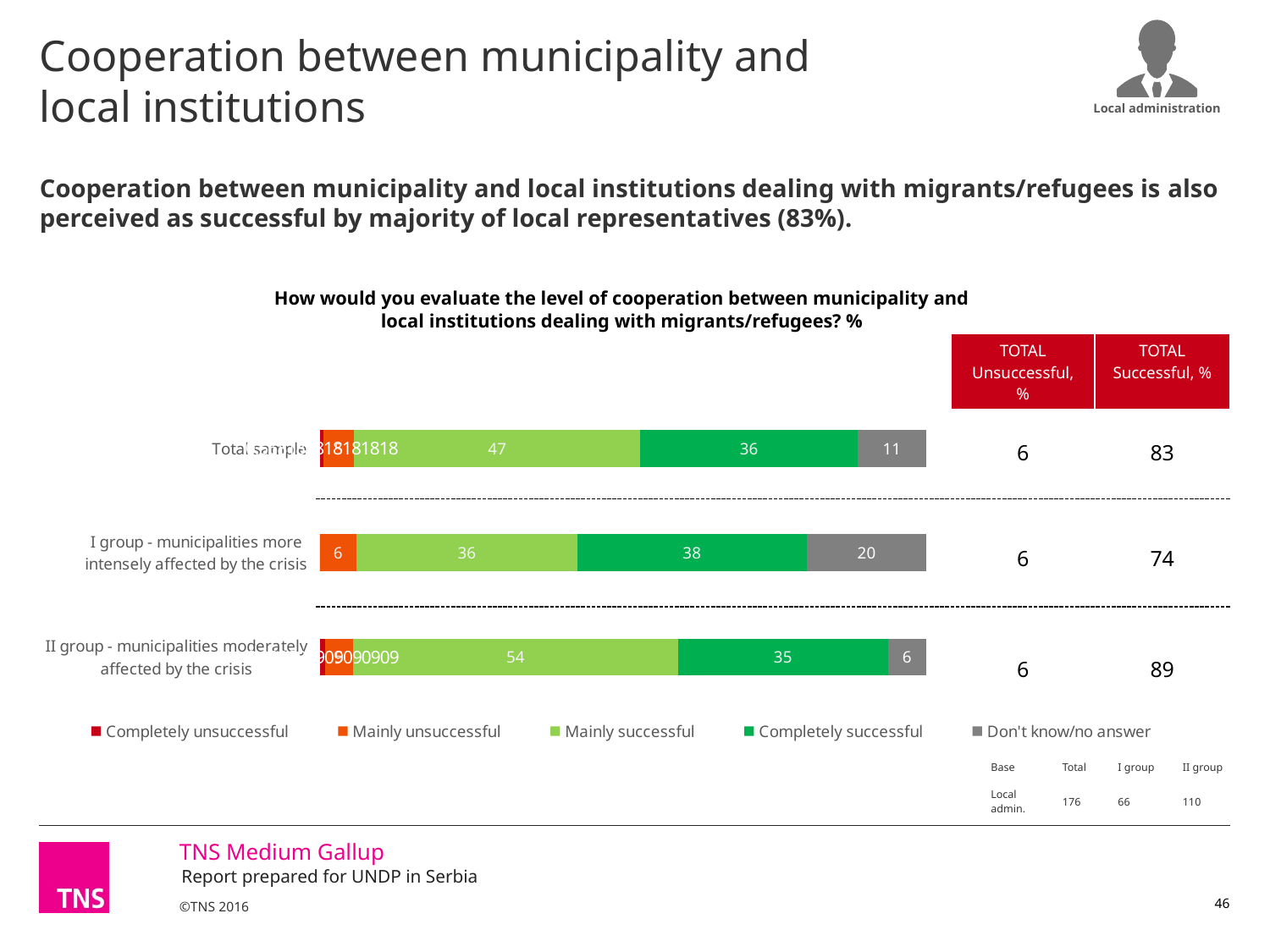
What is the 'Don't know/no answer' value for 'I group - municipalities more intensely affected by the crisis'? 20 What is the 'Mainly successful' value for 'I group - municipalities more intensely affected by the crisis'? 36 Which category has the highest 'Don't know/no answer' value? I group - municipalities more intensely affected by the crisis What is the 'Mainly unsuccessful' value for 'I group - municipalities more intensely affected by the crisis'? 6 What kind of chart is shown on the slide? bar chart How many categories (bars) are plotted in the chart? 3 What is the difference between the 'Mainly successful' values for II group and I group? 18 What is the 'Completely successful' value for 'Total sample'? 36 Which category has the highest 'Mainly successful' value? II group - municipalities moderately affected by the crisis How many series does the chart legend list? 5 Which has the larger 'Completely successful' value, I group or II group? I group - municipalities more intensely affected by the crisis What is the 'Mainly successful' value for 'II group - municipalities moderately affected by the crisis'? 54